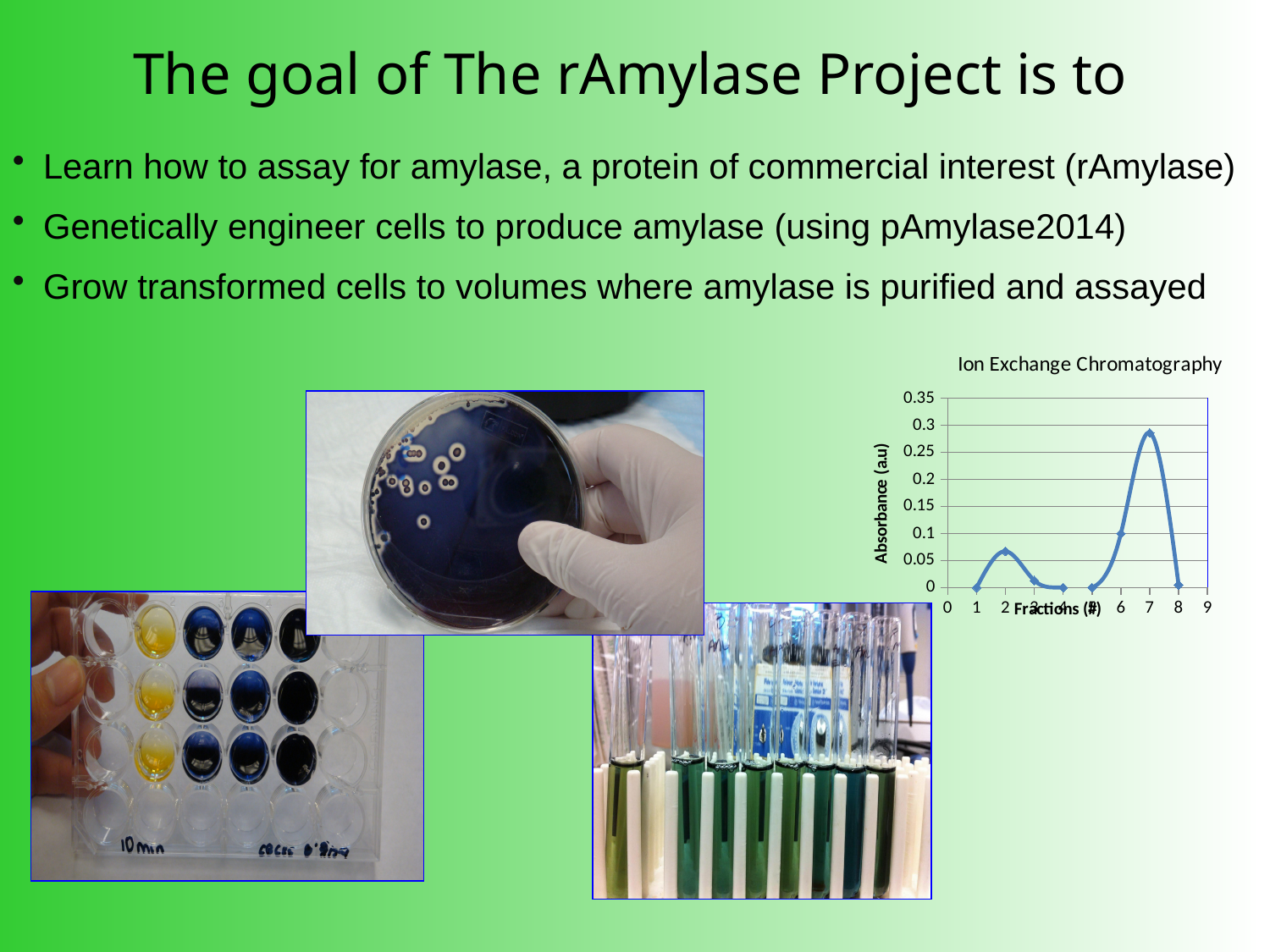
In the Ion Exchange Chromatography chart, at which fraction number is the absorbance highest? 7 In the Ion Exchange Chromatography chart, how many data points are plotted on the line? 8 In the Ion Exchange Chromatography chart, what is the label of the y axis? Absorbance (a.u) In the Ion Exchange Chromatography chart, which has the higher absorbance, fraction 2 or fraction 4? fraction 2 In the Ion Exchange Chromatography chart, does the absorbance rise or fall from fraction 7 to fraction 8? fall In the Ion Exchange Chromatography chart, is the absorbance at fraction 2 greater or less than 0.1? less What is the title of the chart on the slide? Ion Exchange Chromatography In the Ion Exchange Chromatography chart, does the absorbance rise or fall from fraction 5 to fraction 7? rise In the Ion Exchange Chromatography chart, is the absorbance at fraction 3 greater or less than 0.05? less What kind of chart is the Ion Exchange Chromatography chart? line chart In the Ion Exchange Chromatography chart, which has the higher absorbance, fraction 2 or fraction 7? fraction 7 In the Ion Exchange Chromatography chart, is the absorbance at fraction 7 greater or less than 0.25? greater